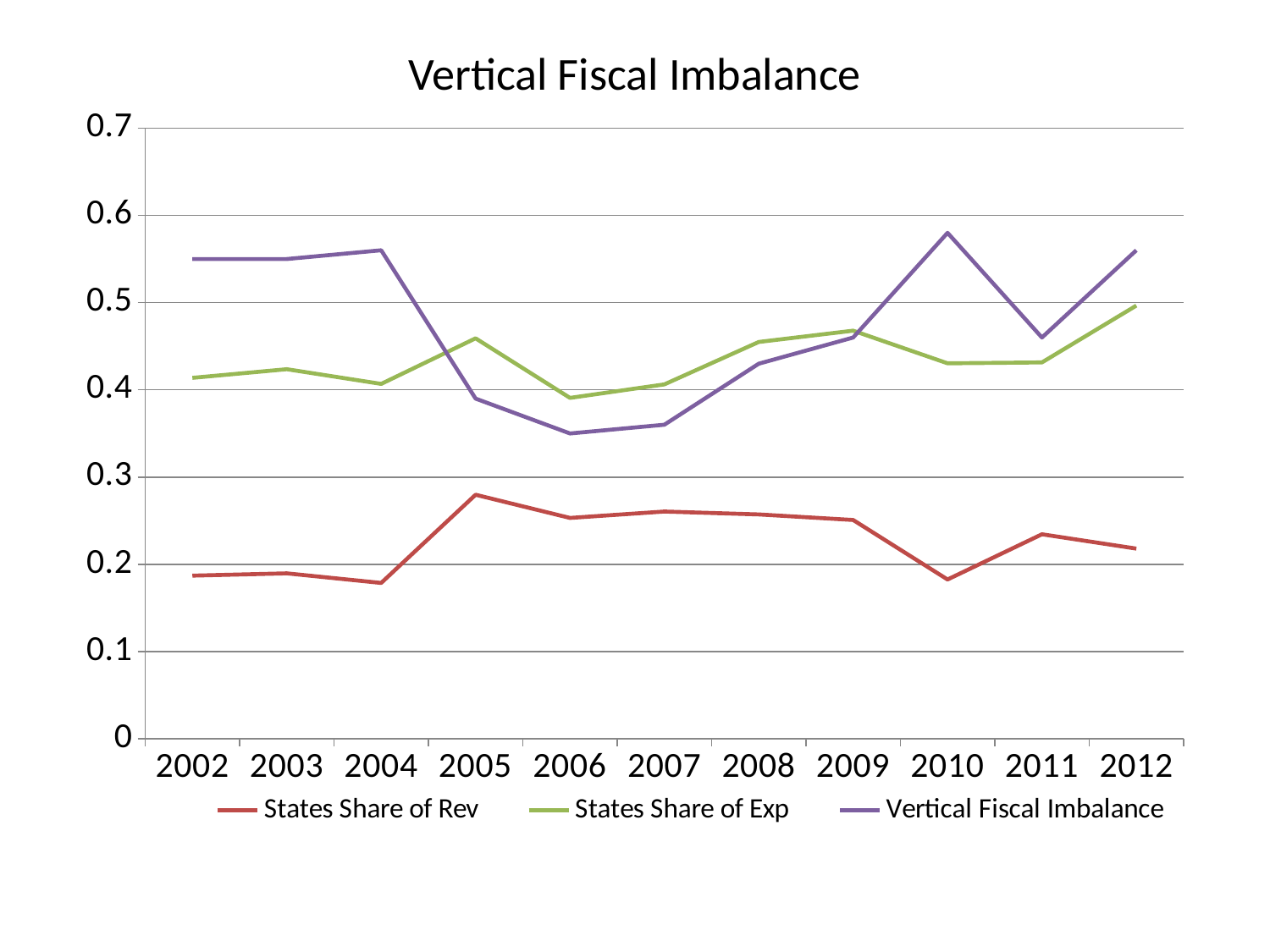
How many years are plotted along the x axis? 11 What kind of chart is shown on the slide? line chart Is the value for States Share of Exp in 2005 greater or less than 0.4? greater In which year is States Share of Exp highest? 2012 Is the value for Vertical Fiscal Imbalance in 2006 greater or less than 0.4? less Is the value for Vertical Fiscal Imbalance in 2010 greater or less than 0.5? greater What is the title of the chart? Vertical Fiscal Imbalance In which year is States Share of Rev highest? 2005 In 2002, which is larger: Vertical Fiscal Imbalance or States Share of Exp? Vertical Fiscal Imbalance In 2006, which is larger: Vertical Fiscal Imbalance or States Share of Exp? States Share of Exp How many series does the legend list? 3